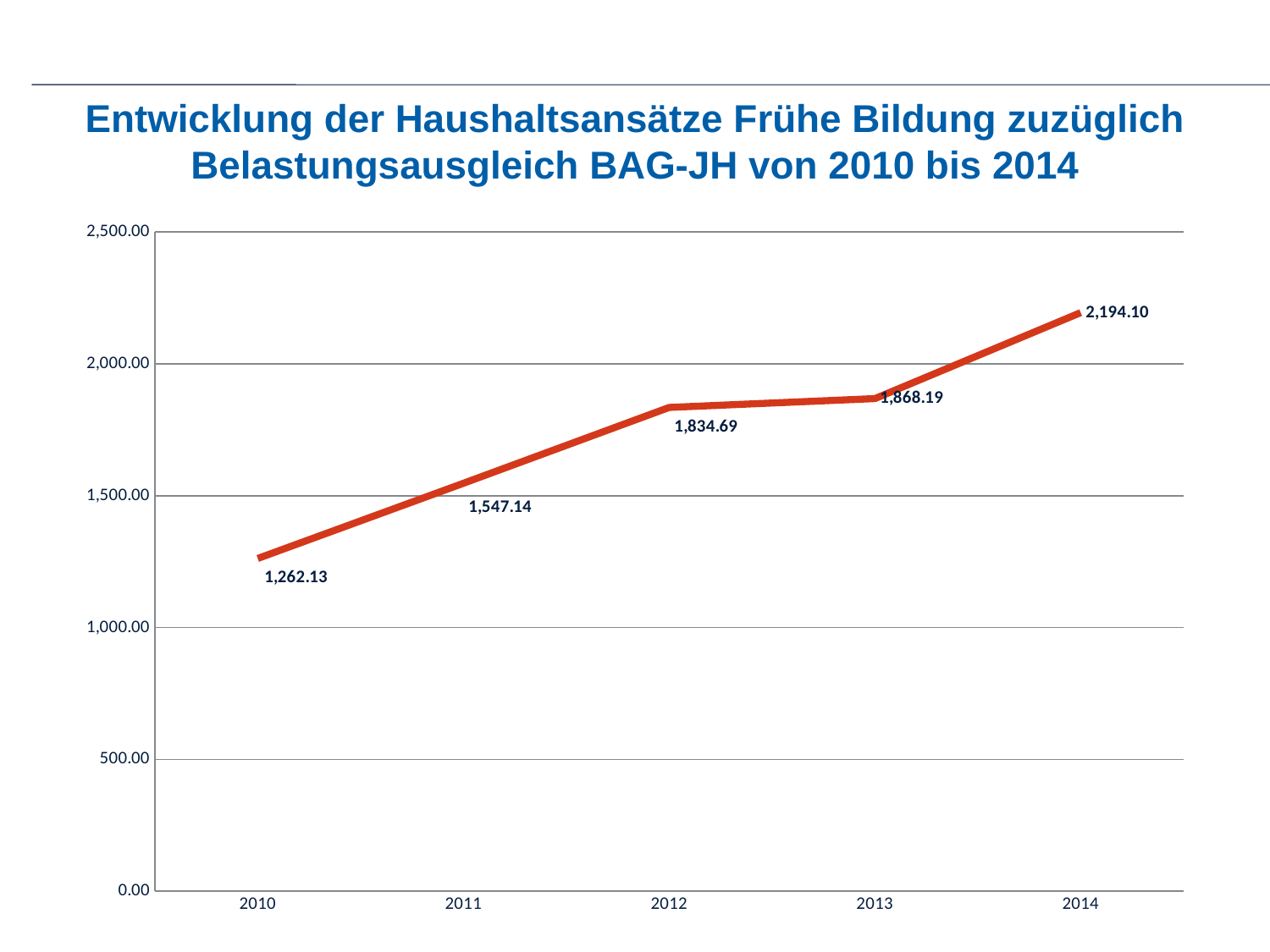
Is the value for 2014 greater or less than 2,000.00? greater Which year has the lowest value? 2010 What is the value for 2014? 2,194.10 What is the difference between the values for 2014 and 2010? 931.97 Do the values rise or fall from 2010 to 2014? rise Which year has the highest value? 2014 What is the value for 2010? 1,262.13 What kind of chart is shown on the slide? line chart What is the difference between the values for 2013 and 2012? 33.50 Which is larger, the value for 2011 or the value for 2013? 2013 How many years are plotted on the x axis? 5 What is the value for 2012? 1,834.69